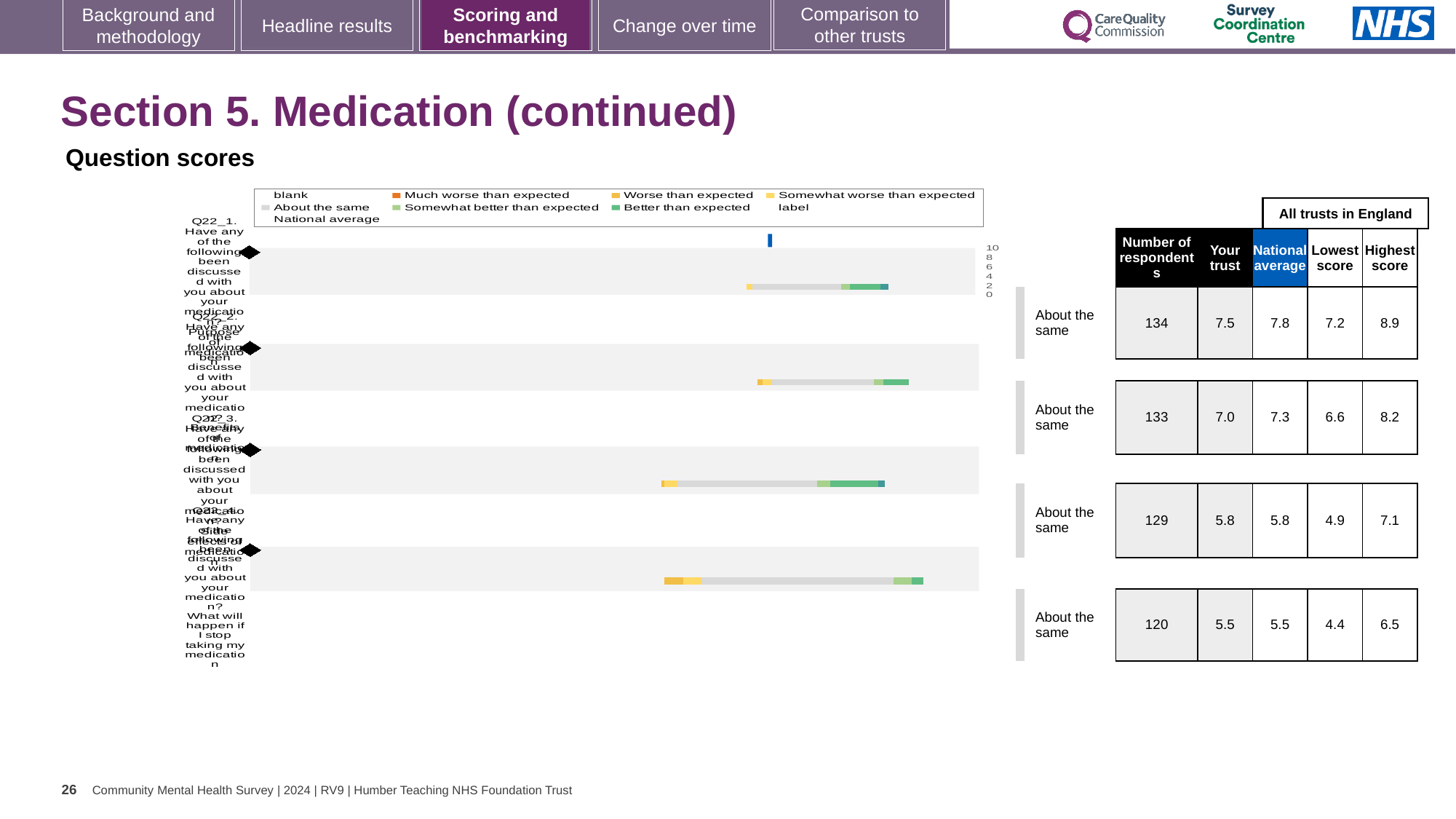
What benchmark category is shown for every question row in the chart? About the same What is the number of respondents for the third question row? 129 What is the lowest score among all trusts in England for the fourth (bottom) question row? 4.4 For the first question row, what is the difference between the highest score (8.9) and the lowest score (7.2)? 1.7 How many question rows are plotted in the chart? 4 Which question row has the highest 'Your trust' score? Q22_1 (the top row), 7.5 Which question row has the lowest 'Your trust' score? the fourth (bottom) row, 5.5 What is the national average for the second question row? 7.3 What heading appears above the Lowest score and Highest score columns of the table? All trusts in England What kind of chart is shown on the slide? bar chart What is the 'Your trust' score for the first (top) question row, Q22_1? 7.5 For the first question row, which is larger: the 'Your trust' score or the national average? National average (7.8)